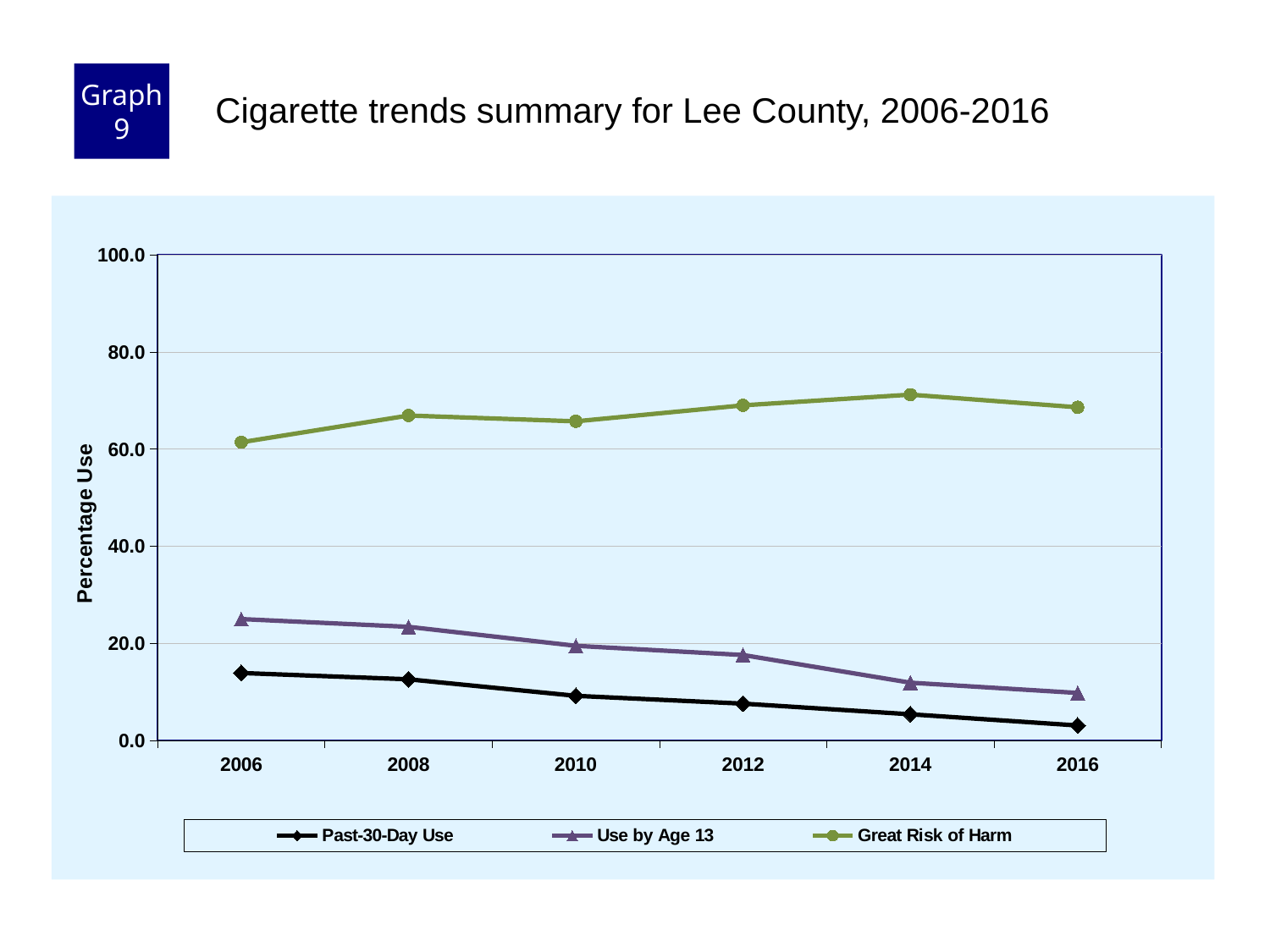
Does the Use by Age 13 series rise or fall from 2006 to 2016? Fall What type of chart is shown on the slide? Line chart Is the value for Use by Age 13 in 2006 greater or less than 20.0? greater Is the value for Great Risk of Harm in 2006 greater or less than 60.0? greater How many years are plotted along the x axis? 6 Is the value for Use by Age 13 in 2016 greater or less than 20.0? less In which year is the Past-30-Day Use series at its lowest? 2016 In which year is the Great Risk of Harm series at its highest? 2014 In 2006, which is larger: Use by Age 13 or Past-30-Day Use? Use by Age 13 What is the label on the y axis? Percentage Use How many series does the legend list? 3 Does the Past-30-Day Use series rise or fall from 2006 to 2016? Fall